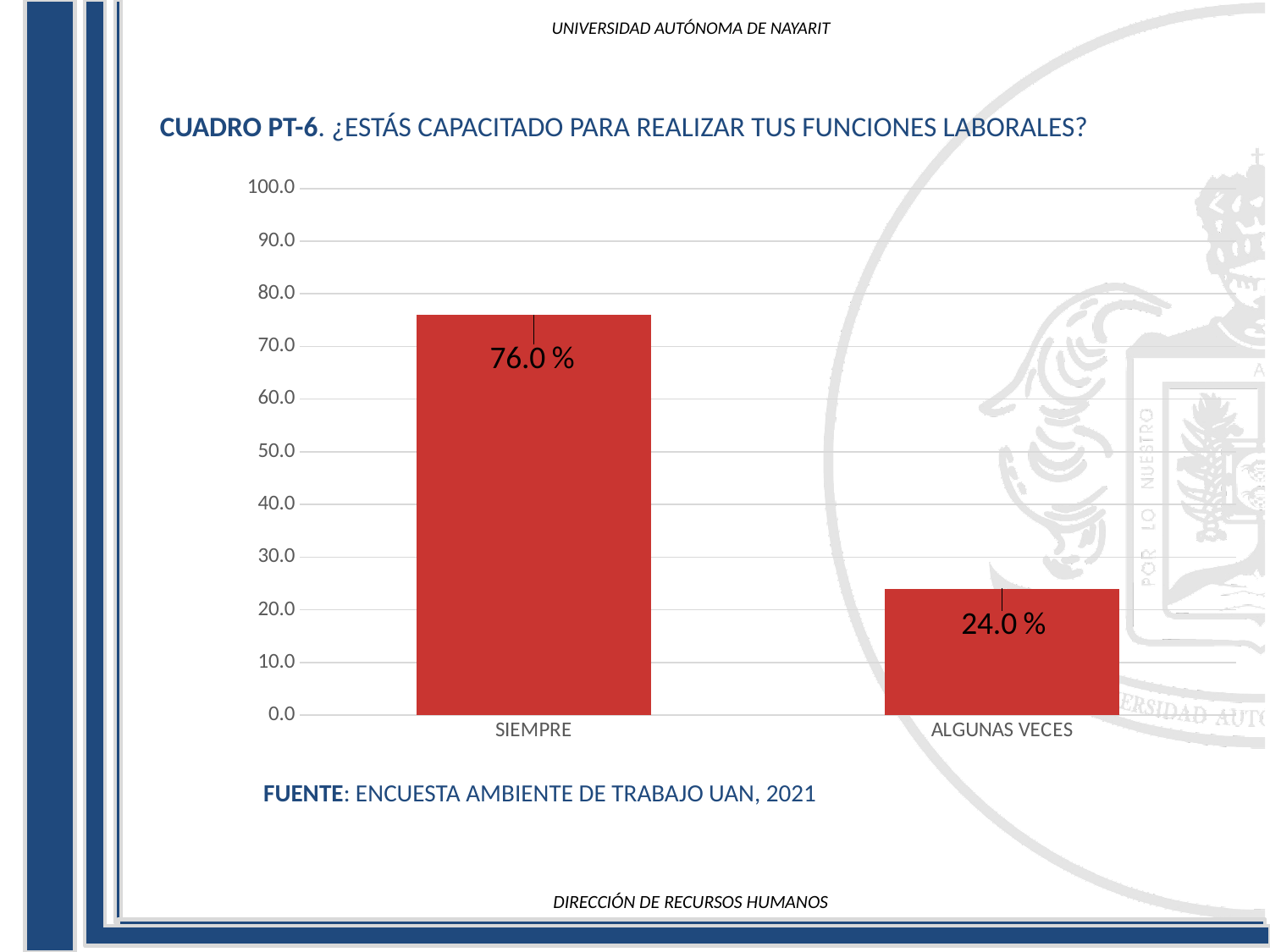
Which category has the lowest value? ALGUNAS VECES What is the maximum value shown on the y axis? 100.0 How many categories are shown on the x axis? 2 What is the difference between the values for SIEMPRE and ALGUNAS VECES? 52.0 % Which category has the highest value? SIEMPRE What is the value for ALGUNAS VECES? 24.0 % What kind of chart is shown on the slide? bar chart Which is larger, the value for SIEMPRE or the value for ALGUNAS VECES? SIEMPRE Is the value for SIEMPRE greater or less than 70.0? greater Is the value for ALGUNAS VECES greater or less than 30.0? less What source is cited below the chart? ENCUESTA AMBIENTE DE TRABAJO UAN, 2021 What is the value for SIEMPRE? 76.0 %